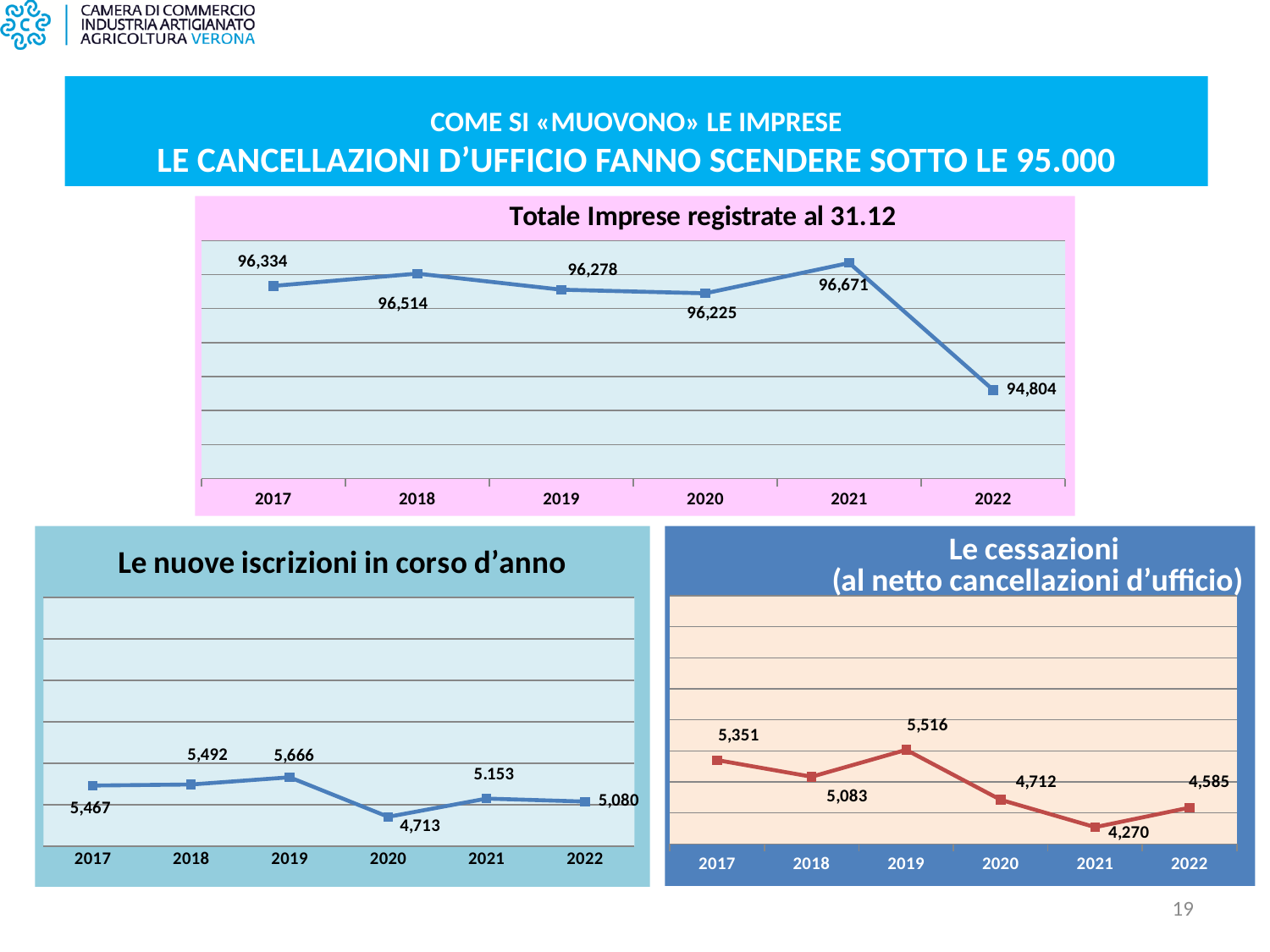
In the chart 'Le cessazioni (al netto cancellazioni d'ufficio)', what is the difference between the 2019 value and the 2021 value? 1,246 In the chart 'Le nuove iscrizioni in corso d'anno', which year has the lowest value? 2020 In the chart 'Totale Imprese registrate al 31.12', what is the difference between the 2021 value and the 2022 value? 1,867 What kind of chart is 'Totale Imprese registrate al 31.12'? line chart In the chart 'Le nuove iscrizioni in corso d'anno', what is the value for 2019? 5,666 In the chart 'Le nuove iscrizioni in corso d'anno', how many years are plotted? 6 In the chart 'Totale Imprese registrate al 31.12', which year has the highest value? 2021 In the chart 'Le cessazioni (al netto cancellazioni d'ufficio)', what is the value for 2021? 4,270 In the chart 'Le cessazioni (al netto cancellazioni d'ufficio)', is the value for 2018 larger or the value for 2020? 2018 In the chart 'Totale Imprese registrate al 31.12', which year has the lowest value? 2022 In the chart 'Totale Imprese registrate al 31.12', what is the value for 2022? 94,804 In the chart 'Le cessazioni (al netto cancellazioni d'ufficio)', which year has the highest value? 2019